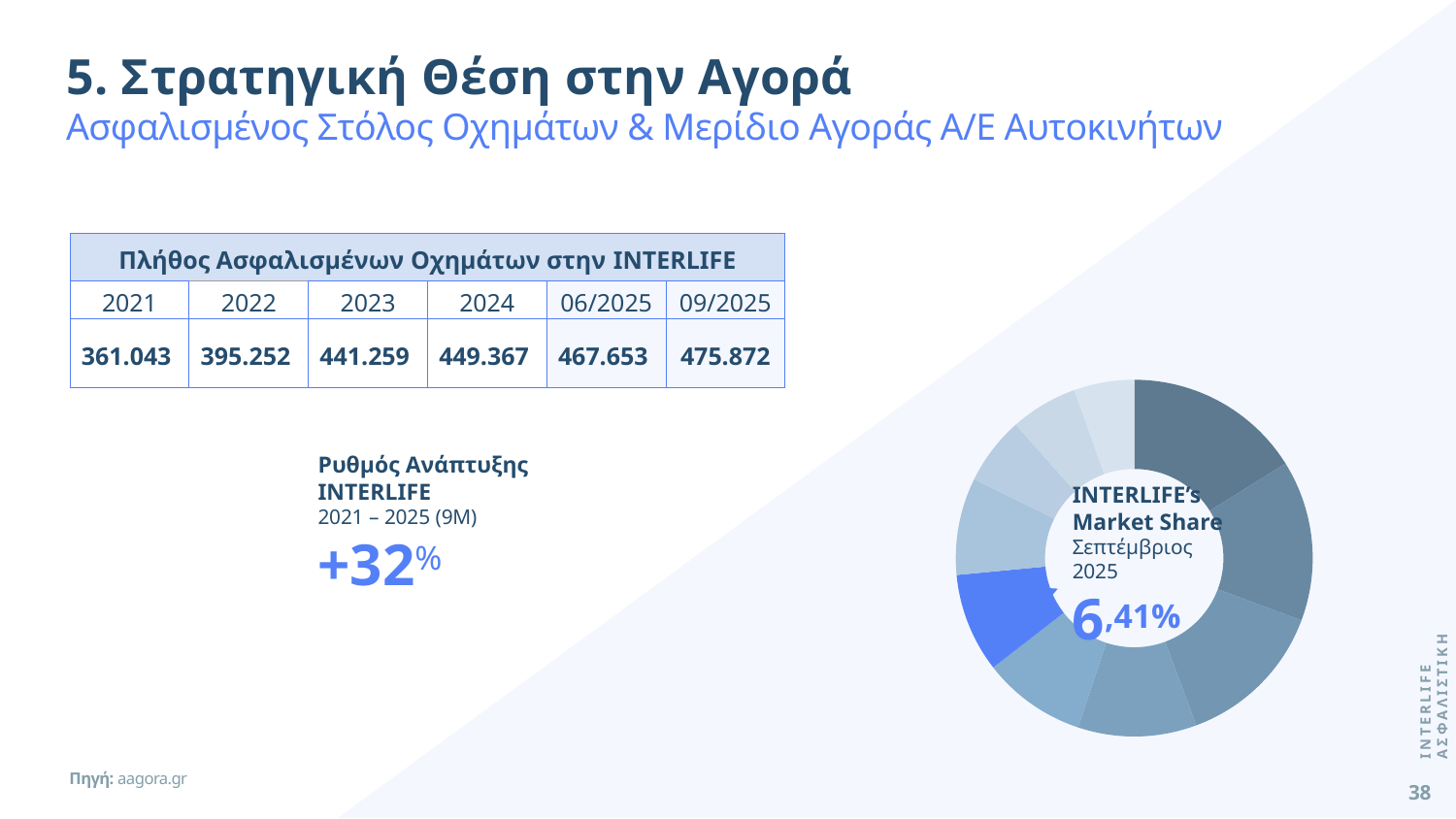
What is INTERLIFE's market share shown in the donut chart? 6,41% Is INTERLIFE's market share in the donut chart greater or less than 10%? less Which is larger in the donut chart: INTERLIFE's highlighted slice or the dark slate slice at the top right? the dark slate slice at the top right Is INTERLIFE's slice the largest slice in the donut chart? No What kind of chart is shown on the right side of the slide? donut (pie) chart What is the title of the donut chart? INTERLIFE's Market Share Which month and year does the donut chart's market share refer to? Σεπτέμβριος 2025